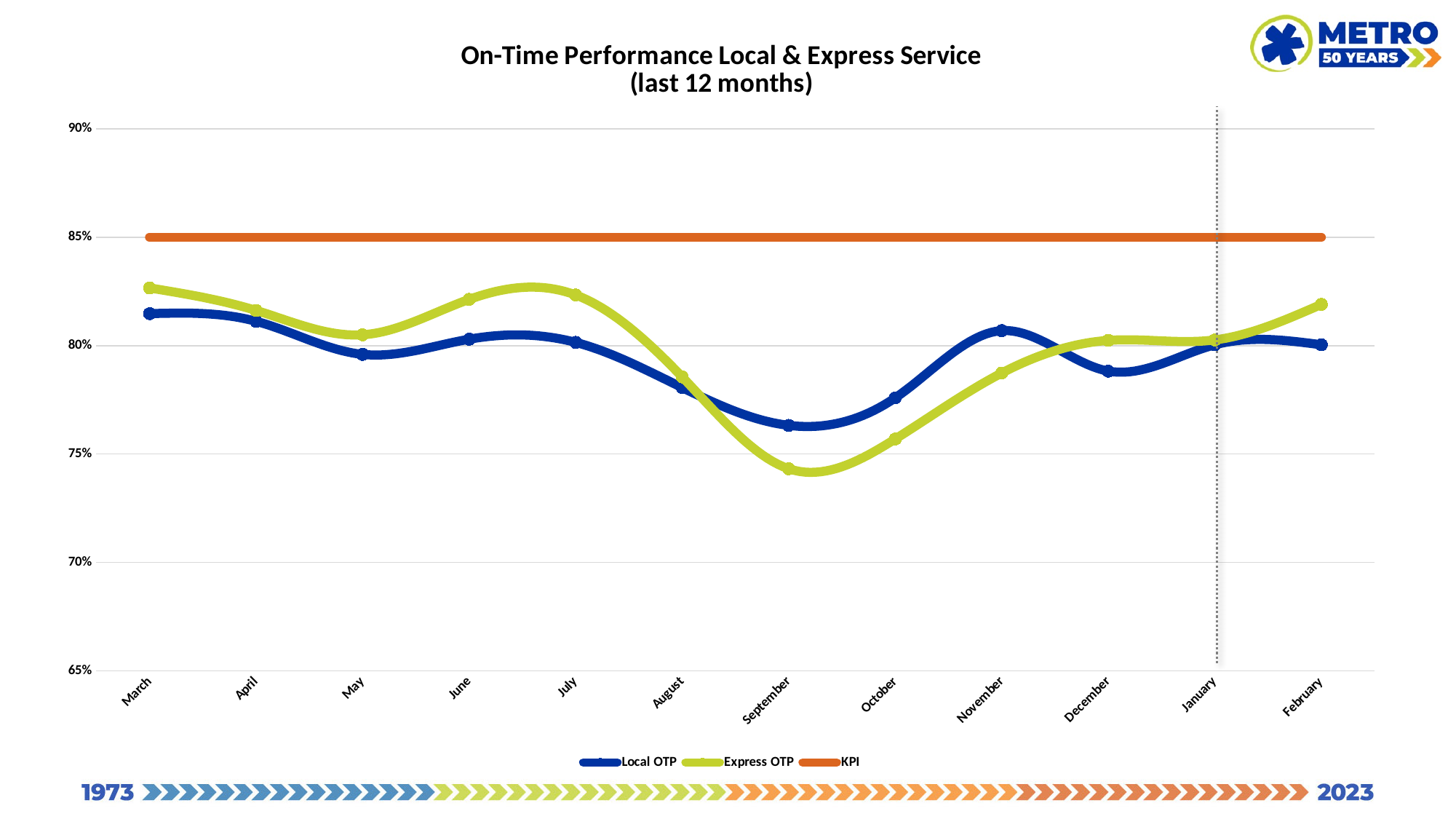
Does Express OTP rise or fall from July to September? fall In September, which series is higher, Local OTP or Express OTP? Local OTP In which month is Express OTP at its lowest? September Is the Local OTP value for November greater or less than 80%? greater What value does the KPI line sit at? 85% How many months are plotted along the x axis? 12 In which month is Local OTP at its lowest? September In December, which series is higher, Local OTP or Express OTP? Express OTP What is the title of the chart? On-Time Performance Local & Express Service (last 12 months) Is the Express OTP value for September greater or less than 75%? less How many series does the legend list? 3 What kind of chart is shown on the slide? line chart